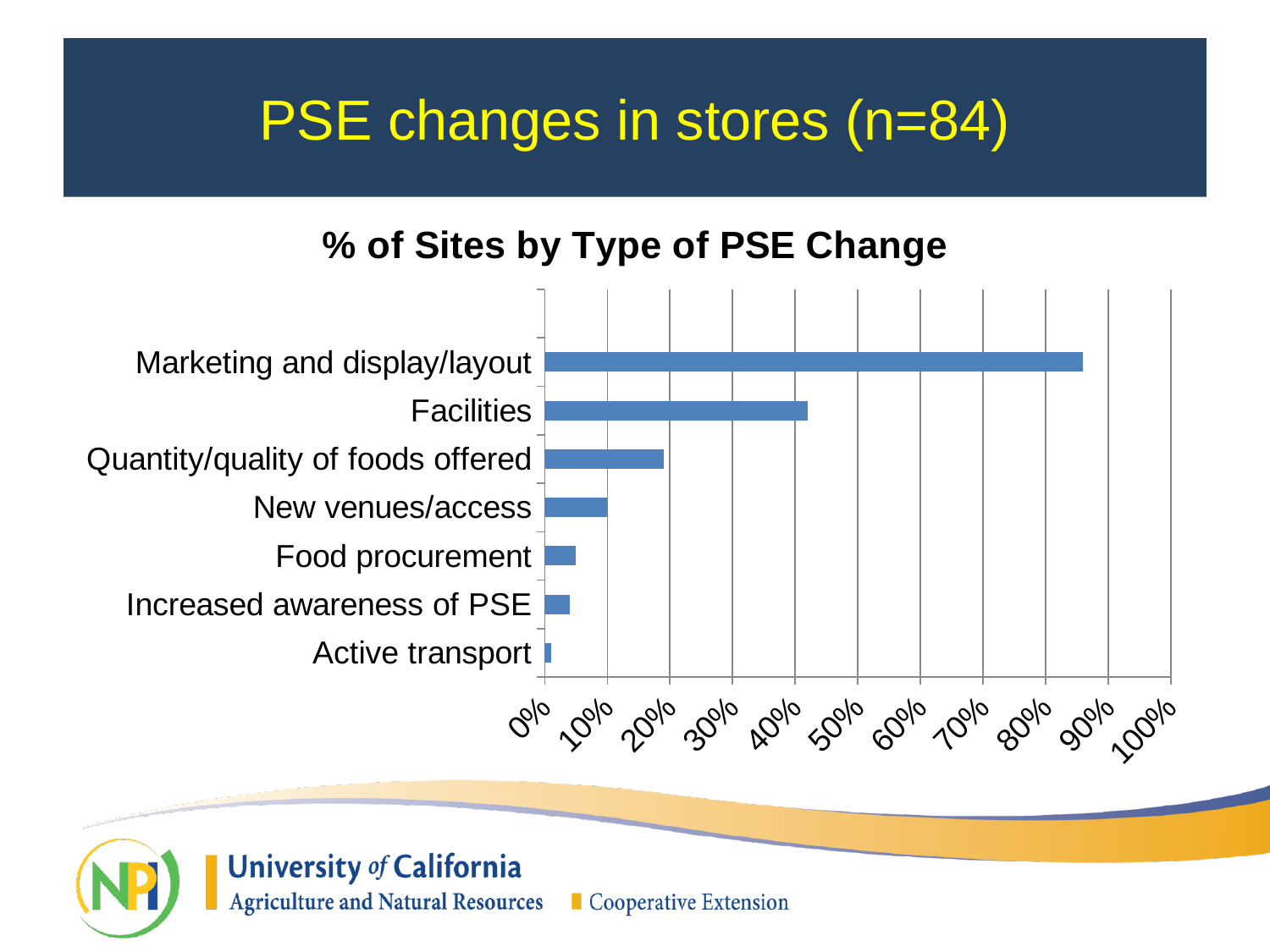
Is the value for Marketing and display/layout greater or less than 80%? greater Which type of PSE change has the lowest percentage of sites? Active transport What kind of chart is shown on the slide? Bar chart Which has a higher percentage of sites, New venues/access or Marketing and display/layout? Marketing and display/layout Which type of PSE change has the highest percentage of sites? Marketing and display/layout Which has a higher percentage of sites, Facilities or Quantity/quality of foods offered? Facilities What is the title of the chart? % of Sites by Type of PSE Change How many types of PSE change are listed on the chart? 7 Is the value for Active transport greater or less than 10%? less Is the value for Food procurement greater or less than 10%? less